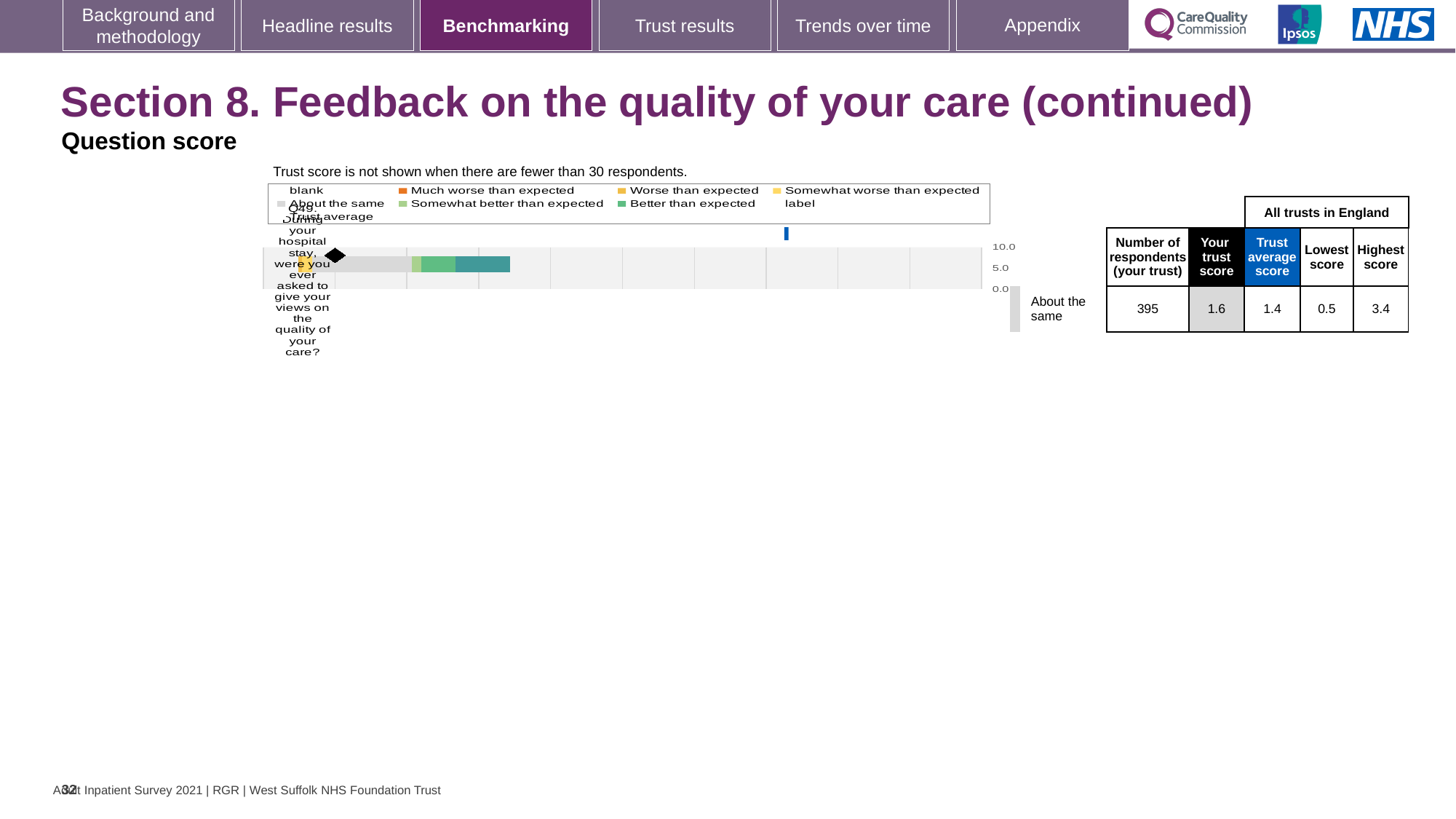
Is your trust score for Q49 greater or less than 5.0 on the chart axis? less How many survey questions are plotted in the chart on this slide? 1 What is the 'Your trust score' value for Q49 shown in the table next to the chart? 1.6 What benchmark category label is shown to the right of the Q49 bar? About the same How many respondents from your trust answered Q49? 395 What is the difference between the highest score and the lowest score for Q49? 2.9 What is the 'Trust average score' for Q49 shown in the table next to the chart? 1.4 What kind of chart is used to show the Q49 benchmark on this slide? bar chart By how much does your trust score exceed the trust average score for Q49? 0.2 What is the 'Lowest score' across all trusts in England for Q49? 0.5 Which is larger for Q49: your trust score or the trust average score? Your trust score What is the 'Highest score' across all trusts in England for Q49? 3.4